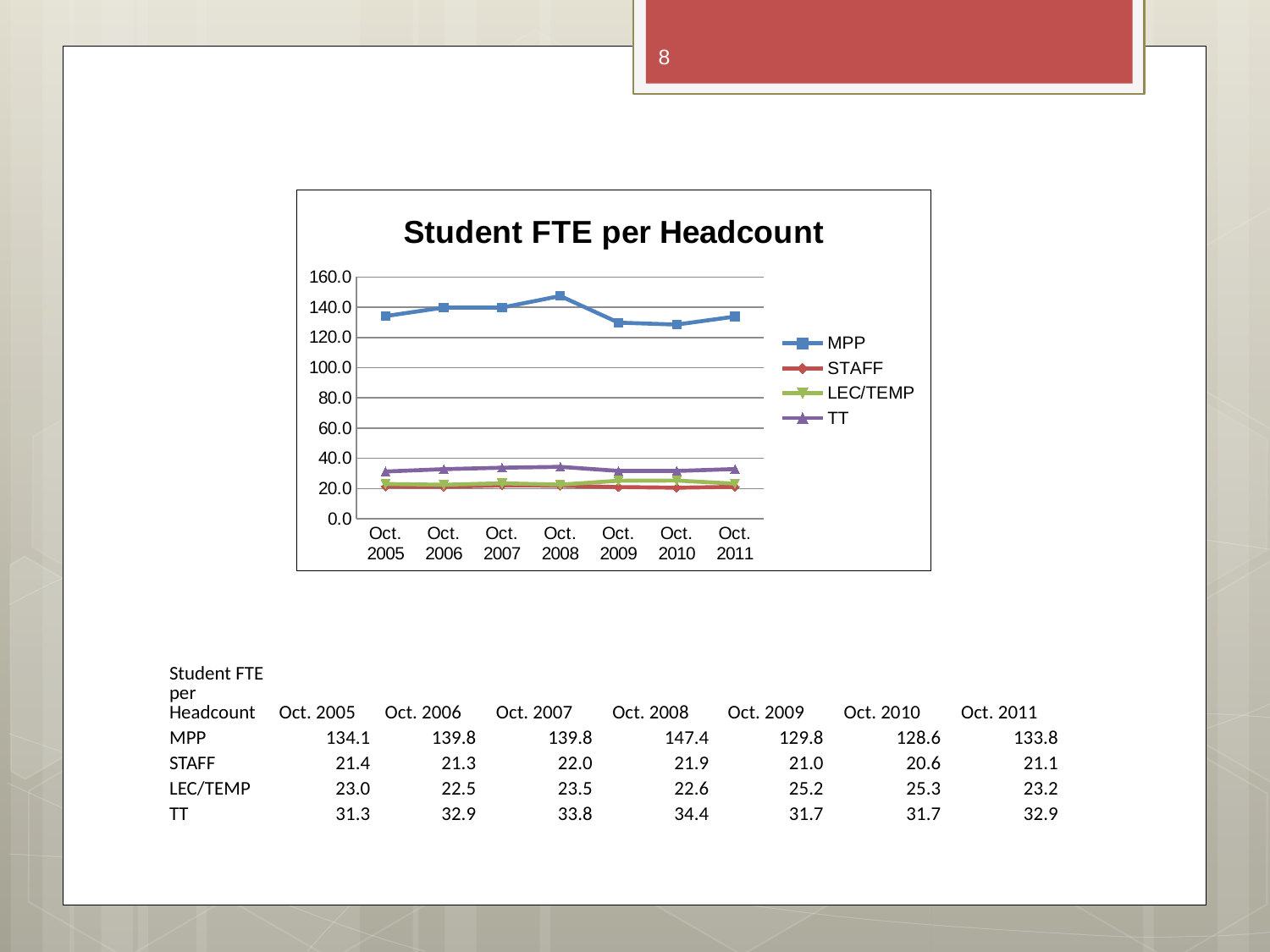
In which year is the MPP value lowest? Oct. 2010 What is the title of the chart? Student FTE per Headcount How many series does the legend list? 4 What is the TT value for Oct. 2007? 33.8 How many time points are plotted along the x axis? 7 Which series has the highest values across all years? MPP What type of chart is shown on the slide? line chart What is the MPP value for Oct. 2008? 147.4 Is the MPP value for Oct. 2008 greater or less than 140? greater In which year does the MPP series reach its highest value? Oct. 2008 What is the difference between the MPP values for Oct. 2008 and Oct. 2009? 17.6 Does the MPP series rise or fall from Oct. 2008 to Oct. 2009? fall